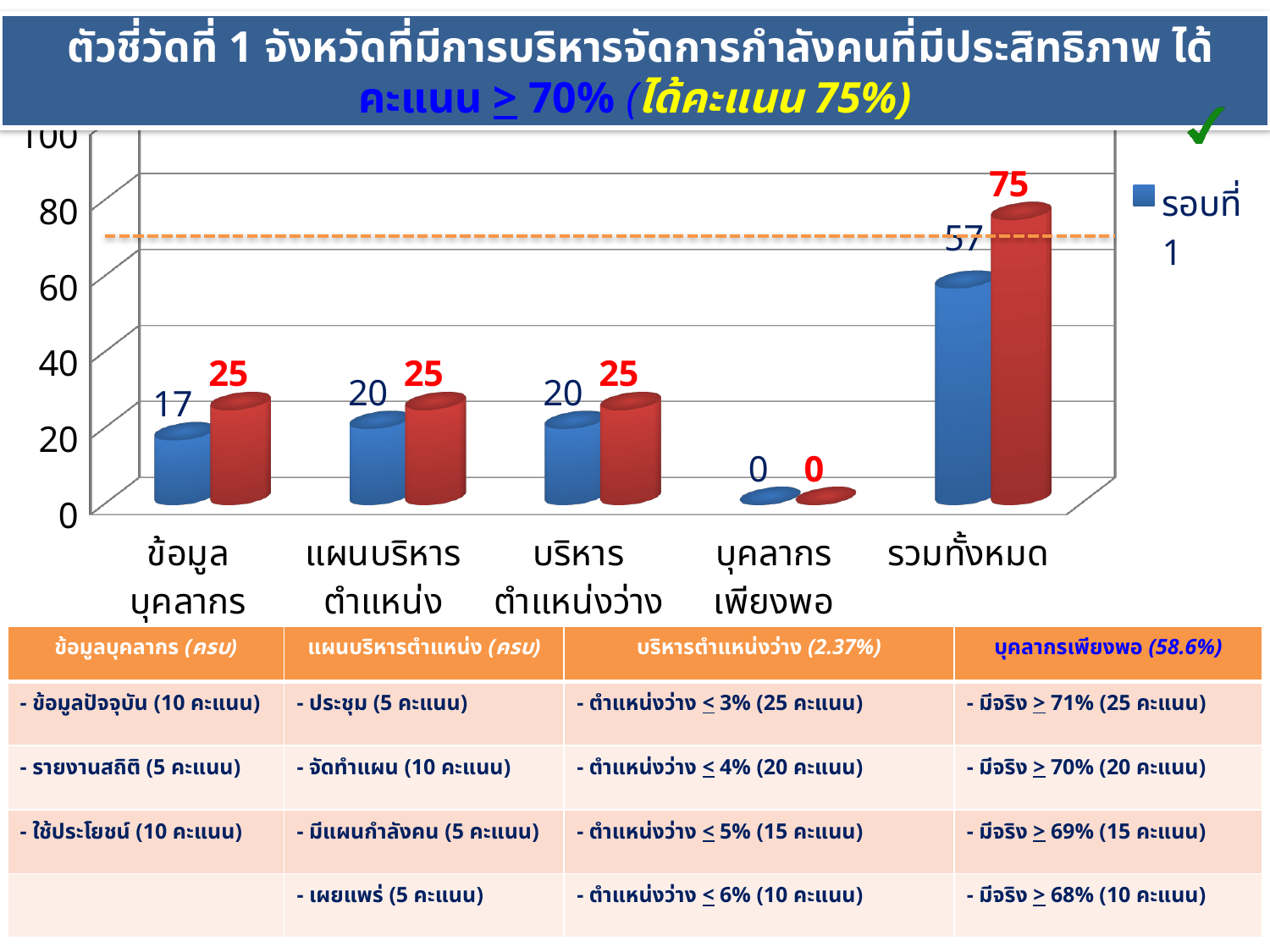
Which category has the highest blue bar (รอบที่ 1)? รวมทั้งหมด What is the value of the red bar for รวมทั้งหมด? 75 How many categories are shown on the x axis of the chart? 5 What is the value of the blue bar (รอบที่ 1) for รวมทั้งหมด? 57 What is the difference between the red bar and the blue bar for ข้อมูลบุคลากร? 8 Which is larger for บริหารตำแหน่งว่าง: the blue bar or the red bar? the red bar Which category has the lowest red bar? บุคลากรเพียงพอ What is the difference between the red bar and the blue bar for รวมทั้งหมด? 18 What is the value of the red bar for แผนบริหารตำแหน่ง? 25 What type of chart is shown on the slide? bar chart What is the value of the blue bar (รอบที่ 1) for ข้อมูลบุคลากร? 17 What is the legend entry shown for the blue series? รอบที่ 1